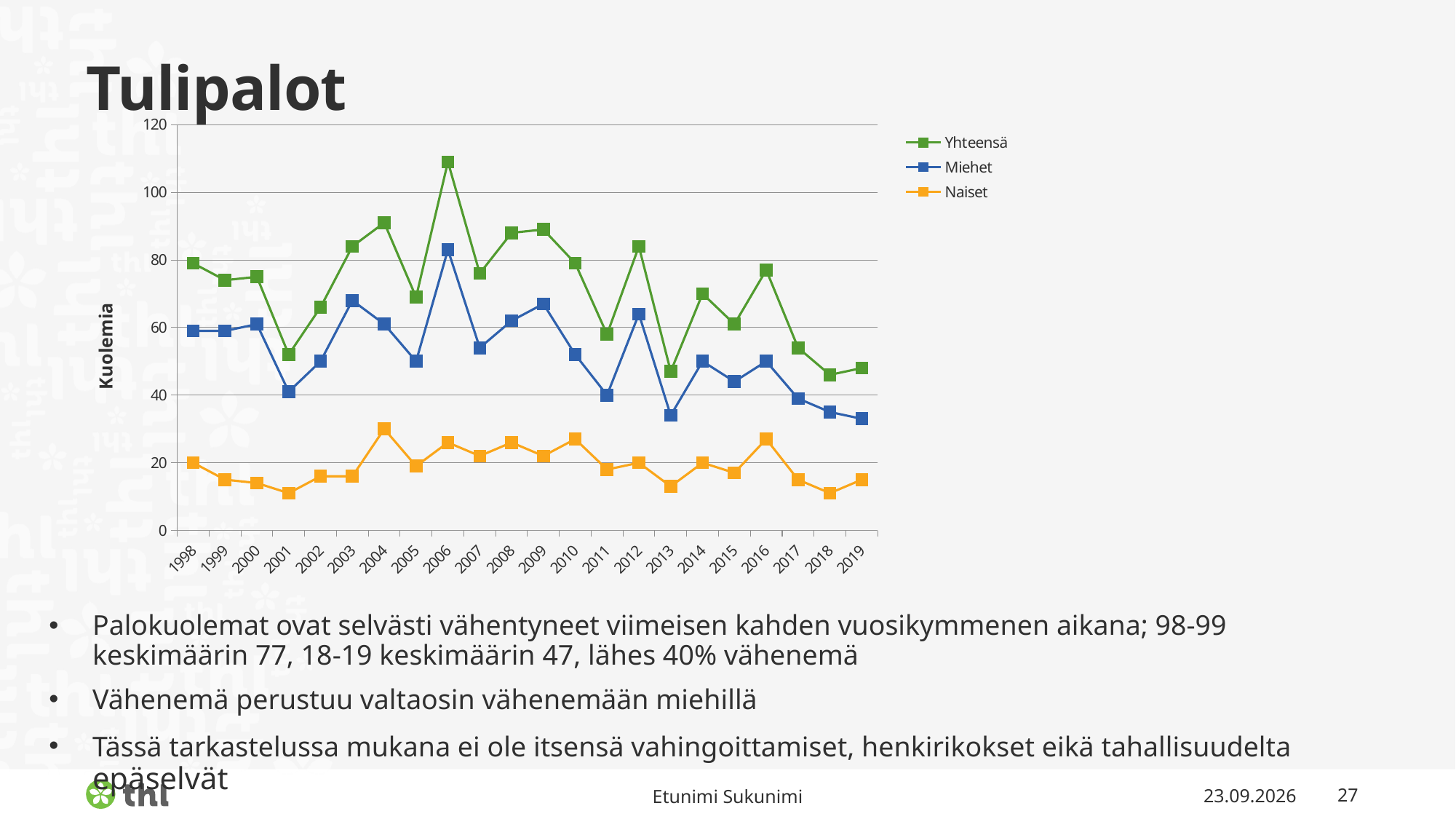
What is the label on the vertical axis of the chart? Kuolemia Is the Yhteensä value for 2006 greater or less than 100? greater Is the Miehet value for 2001 greater or less than 50? less How many series does the chart legend list? 3 In which year does the Yhteensä series reach its highest value? 2006 Which is larger, the Yhteensä value for 1998 or for 2019? 1998 In which year does the Miehet series reach its highest value? 2006 Overall, does the Yhteensä series rise or fall from 1998 to 2019? fall How many years are plotted along the x axis of the chart? 22 What kind of chart is shown on the slide? line chart Is the Naiset value for 2004 greater or less than 20? greater